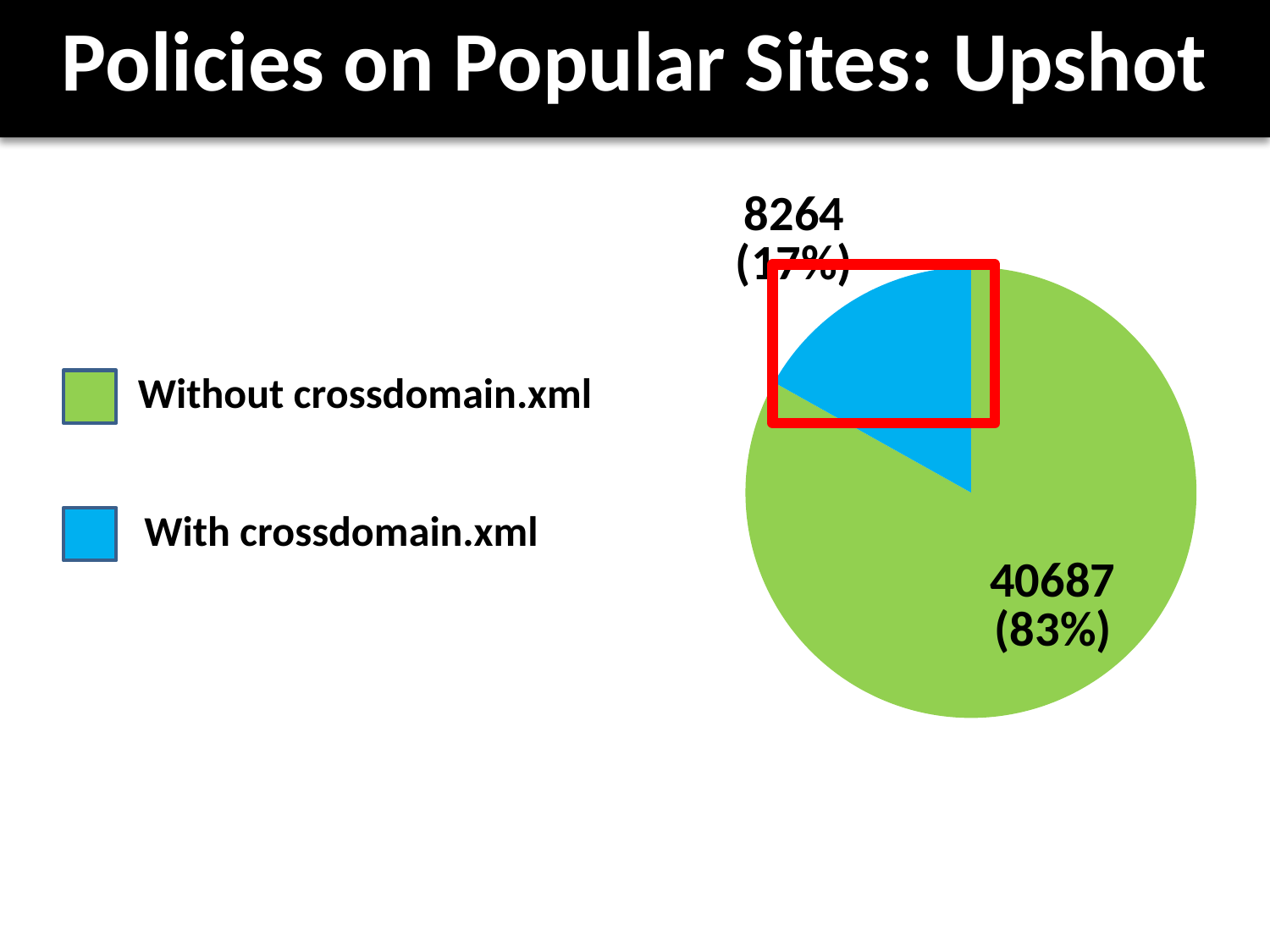
How many sites are with crossdomain.xml according to the pie chart? 8264 How many sites are without crossdomain.xml according to the pie chart? 40687 What is the total number of sites represented in the pie chart? 48951 Which slice of the pie chart is the smallest? With crossdomain.xml What kind of chart is shown on the slide? pie chart What colour is the 'With crossdomain.xml' slice in the pie chart? blue What share of the pie does the 'With crossdomain.xml' slice represent? 17% Which is larger: the number of sites with crossdomain.xml or without crossdomain.xml? Without crossdomain.xml How many slices does the pie chart have? 2 Which slice of the pie chart is the largest? Without crossdomain.xml What share of the pie does the 'Without crossdomain.xml' slice represent? 83% What is the difference between the number of sites without crossdomain.xml and the number with crossdomain.xml? 32423